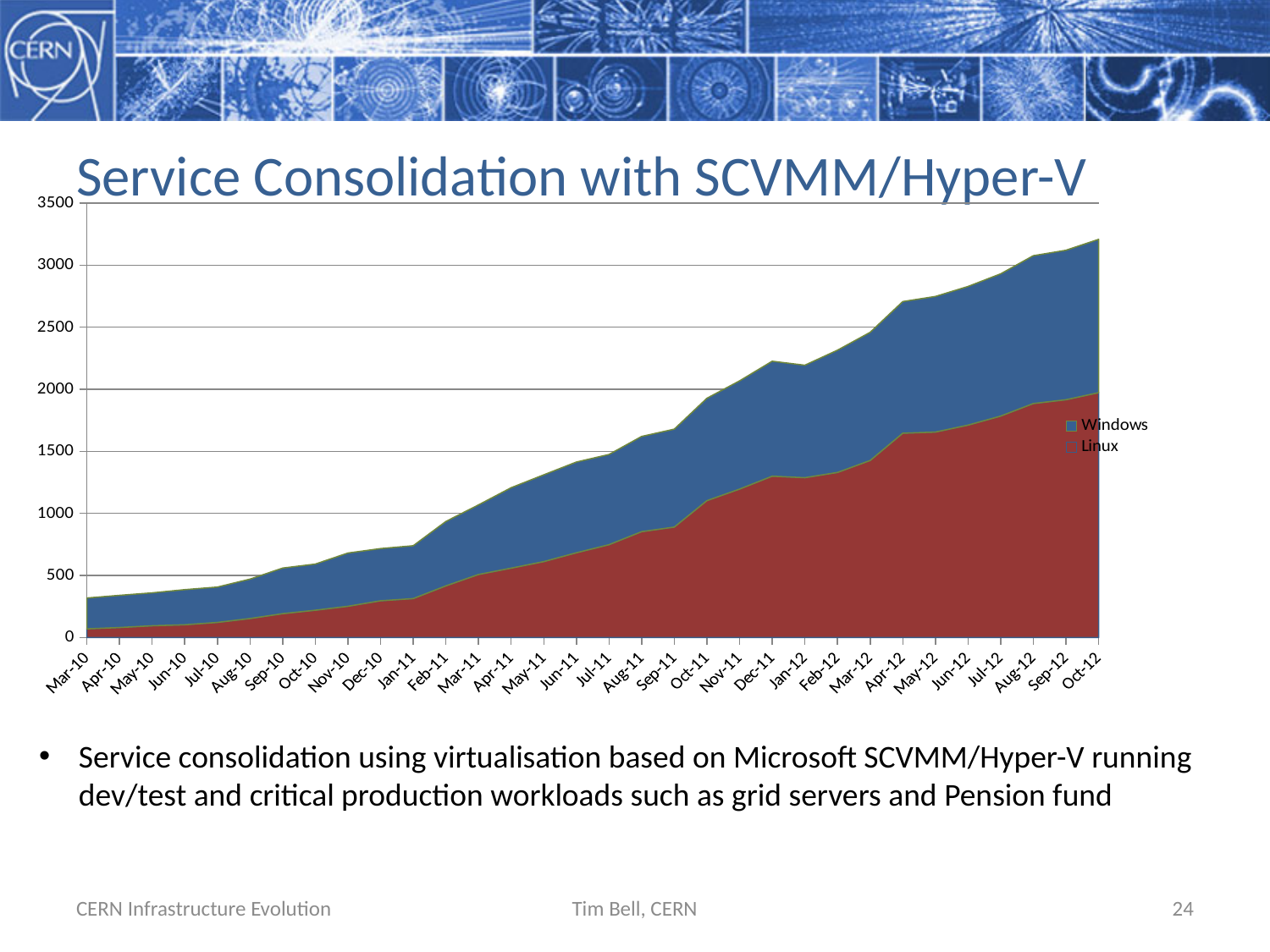
Is the total (Windows plus Linux) value for Oct-12 greater or less than 3000? greater Which month has the highest total value? Oct-12 How many months are shown along the x axis? 32 Which two series are listed in the legend? Windows and Linux Is the total (Windows plus Linux) value for Mar-10 greater or less than 500? less What kind of chart is shown on the slide? Stacked area chart How many series does the legend list? 2 What colour is the Linux area in the chart? Red Is the total (Windows plus Linux) value for Dec-11 greater or less than 2000? greater Do the total values rise or fall from Mar-10 to Oct-12? Rise